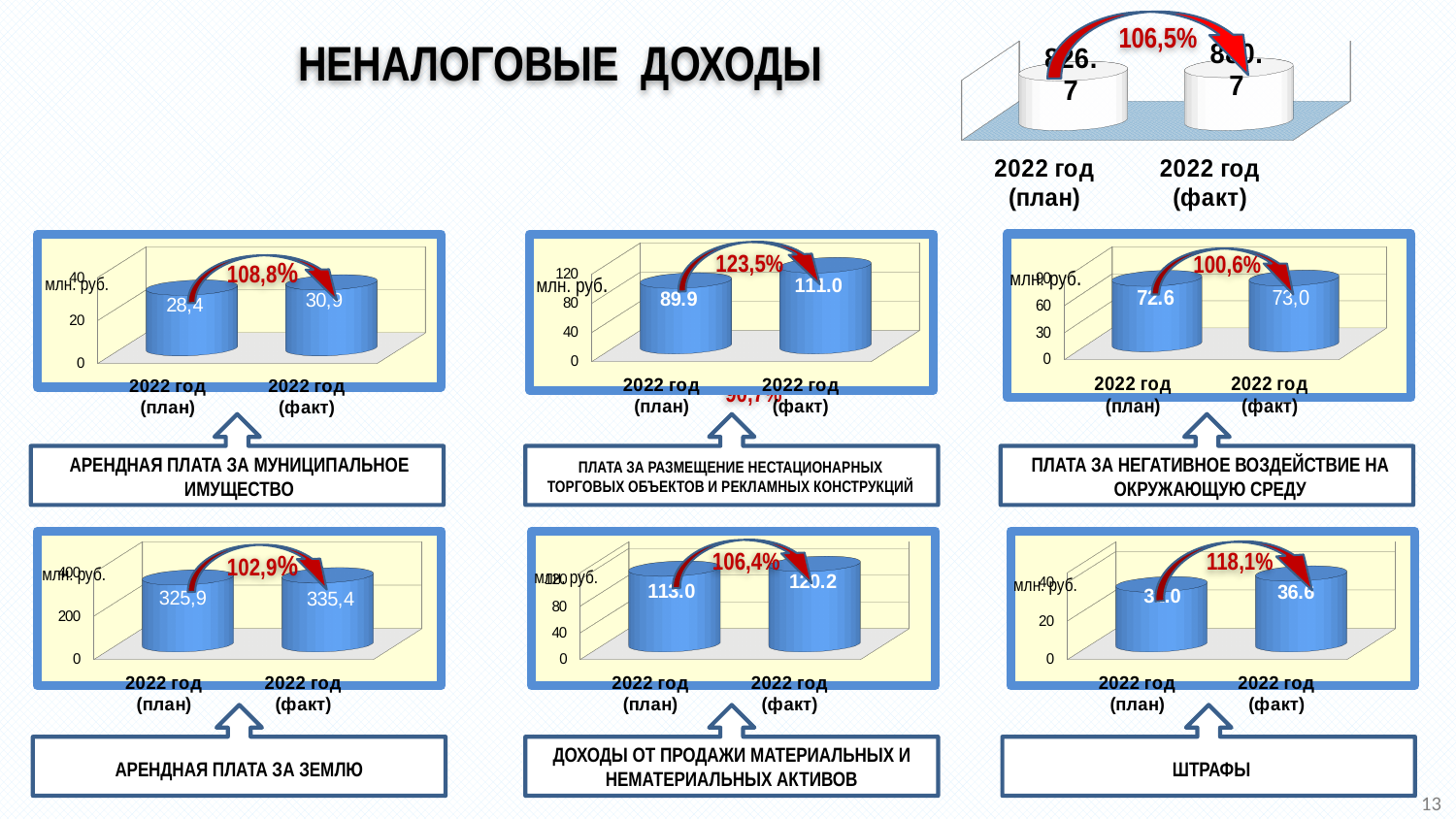
In the chart above 'АРЕНДНАЯ ПЛАТА ЗА МУНИЦИПАЛЬНОЕ ИМУЩЕСТВО', what is the value for 2022 год (план)? 28,4 In the chart above 'ПЛАТА ЗА РАЗМЕЩЕНИЕ НЕСТАЦИОНАРНЫХ ТОРГОВЫХ ОБЪЕКТОВ И РЕКЛАМНЫХ КОНСТРУКЦИЙ', what is the value for 2022 год (план)? 89.9 In the chart above 'ПЛАТА ЗА РАЗМЕЩЕНИЕ НЕСТАЦИОНАРНЫХ ТОРГОВЫХ ОБЪЕКТОВ И РЕКЛАМНЫХ КОНСТРУКЦИЙ', what is the value for 2022 год (факт)? 111.0 How many categories does the chart above 'АРЕНДНАЯ ПЛАТА ЗА ЗЕМЛЮ' show? 2 What kind of chart is the one above 'ШТРАФЫ'? bar chart What percentage is shown on the arrow in the chart above 'ДОХОДЫ ОТ ПРОДАЖИ МАТЕРИАЛЬНЫХ И НЕМАТЕРИАЛЬНЫХ АКТИВОВ'? 106,4% In the chart above 'ПЛАТА ЗА НЕГАТИВНОЕ ВОЗДЕЙСТВИЕ НА ОКРУЖАЮЩУЮ СРЕДУ', what is the value for 2022 год (план)? 72.6 In the chart above 'АРЕНДНАЯ ПЛАТА ЗА ЗЕМЛЮ', what is the value for 2022 год (факт)? 335,4 In the chart above 'ПЛАТА ЗА РАЗМЕЩЕНИЕ НЕСТАЦИОНАРНЫХ ТОРГОВЫХ ОБЪЕКТОВ И РЕКЛАМНЫХ КОНСТРУКЦИЙ', which is larger: 2022 год (план) or 2022 год (факт)? 2022 год (факт) In the chart above 'АРЕНДНАЯ ПЛАТА ЗА МУНИЦИПАЛЬНОЕ ИМУЩЕСТВО', what is the value for 2022 год (факт)? 30,9 In the chart above 'ШТРАФЫ', what is the value for 2022 год (факт)? 36.6 In the chart above 'АРЕНДНАЯ ПЛАТА ЗА ЗЕМЛЮ', what is the difference between the 2022 год (факт) and 2022 год (план) values? 9,5